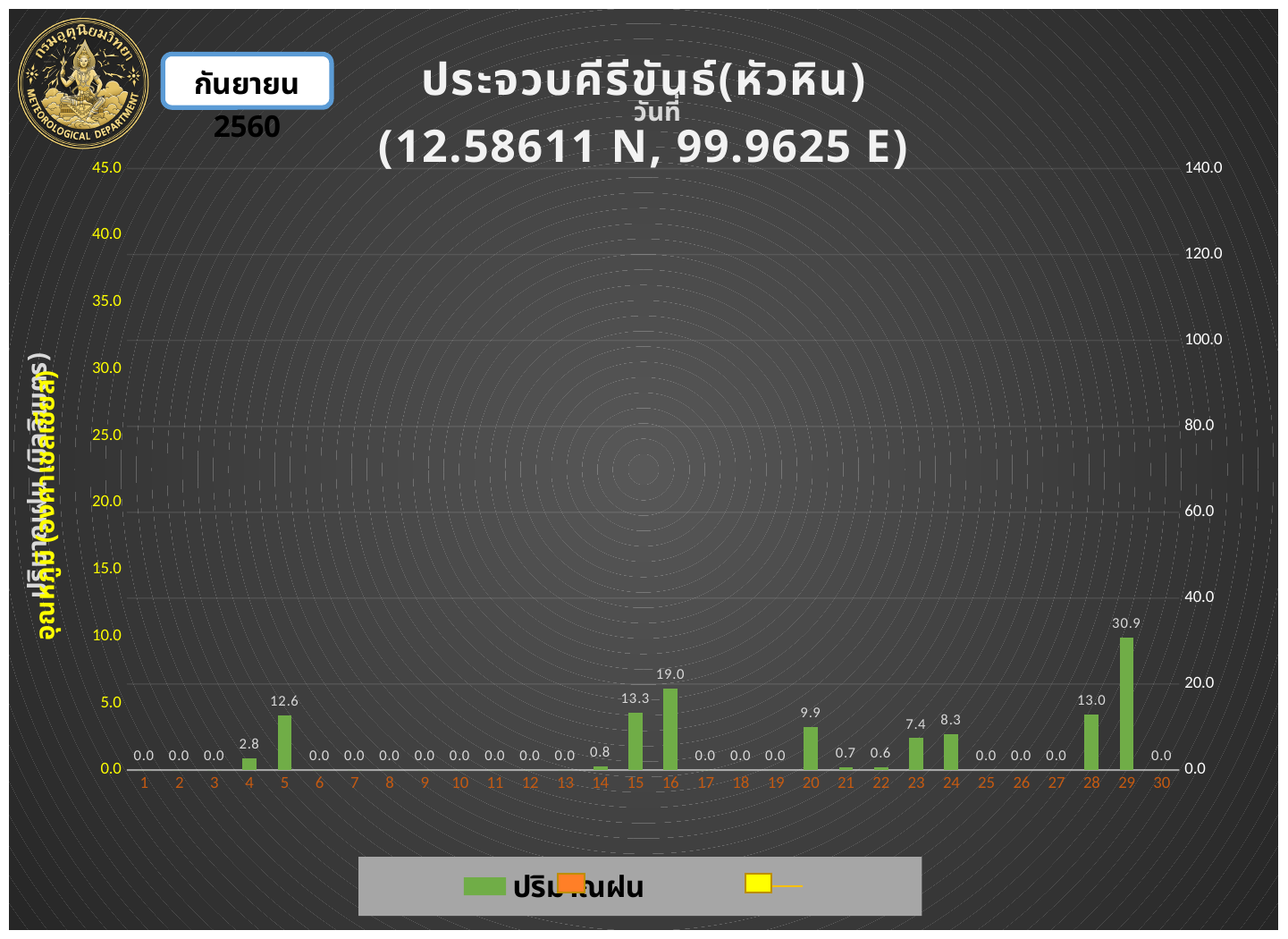
What is the difference between the values for day 29 and day 16? 11.9 Which day has the highest bar in the chart? 29 What is the value labelled on the bar for day 16? 19.0 Which is larger, the value for day 23 or the value for day 24? day 24 What is the rainfall value shown for day 29? 30.9 Which is larger, the value for day 5 or the value for day 20? day 5 What is the value shown for day 20? 9.9 What are the coordinates given in the chart title? 12.58611 N, 99.9625 E How many days are shown on the x axis of the chart? 30 What is the difference between the values for day 15 and day 28? 0.3 What kind of chart is shown on the slide? bar chart What is the value shown for day 5? 12.6